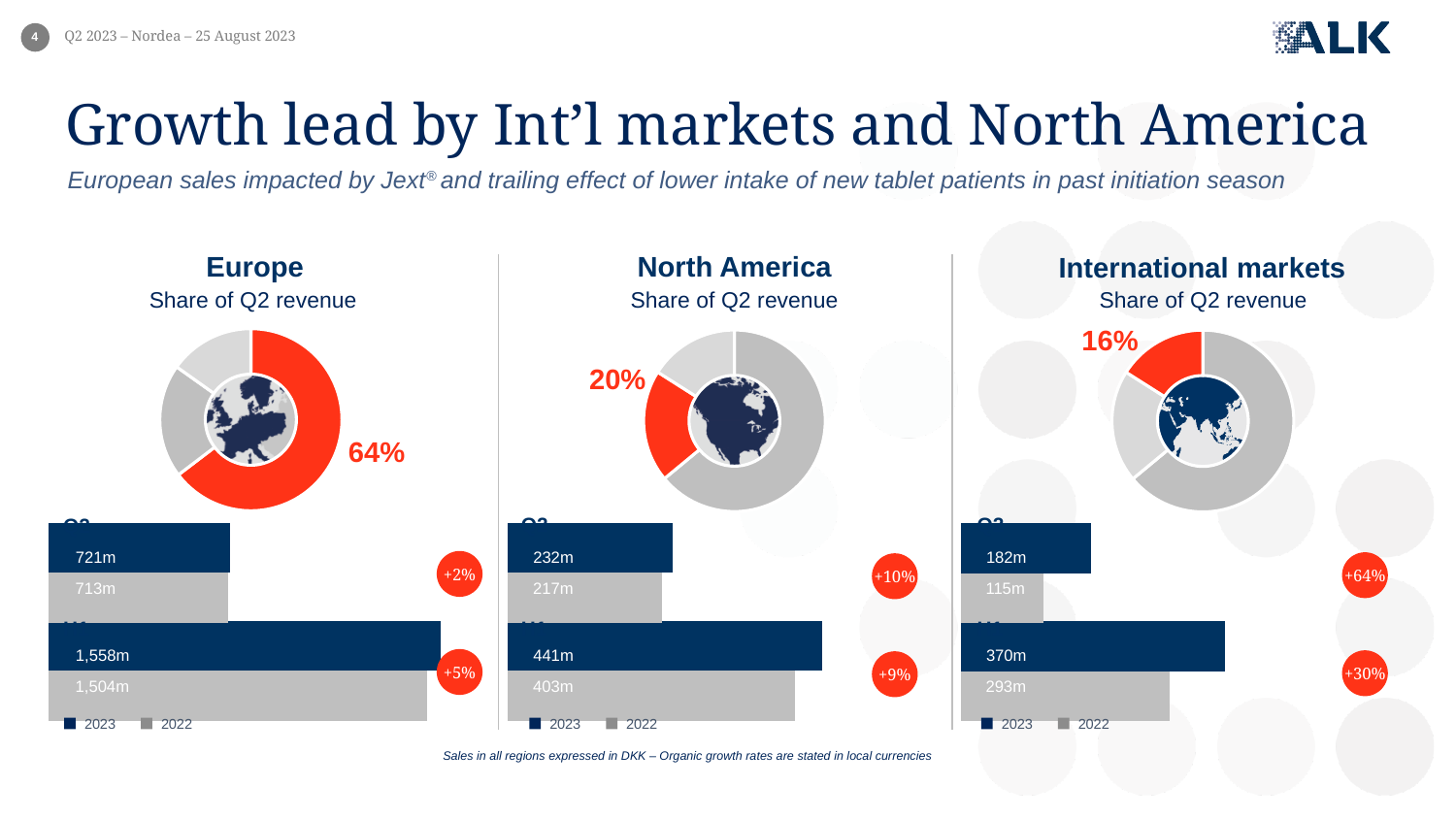
Across the three donut charts, which region has the largest share of Q2 revenue? Europe In the International markets bar chart, what is the difference between the 2023 and 2022 values in the top pair of bars (182m and 115m)? 67m In the International markets donut chart, what share of Q2 revenue is shown for International markets? 16% In the North America donut chart, what share of Q2 revenue is shown for North America? 20% In the Europe bar chart, what is the 2022 value of the bottom pair of bars? 1,504m Across the three donut charts, which region has the smallest share of Q2 revenue? International markets In the Europe donut chart, what share of Q2 revenue does Europe account for? 64% How many series does the legend of the Europe bar chart list? 2 In the International markets bar chart, what is the 2022 value of the top pair of bars? 115m In the Europe bar chart, what is the 2023 value of the top pair of bars? 721m In the North America bar chart, which is larger in the top pair of bars: the 2023 value or the 2022 value? 2023 In the North America bar chart, what is the 2023 value of the bottom pair of bars? 441m